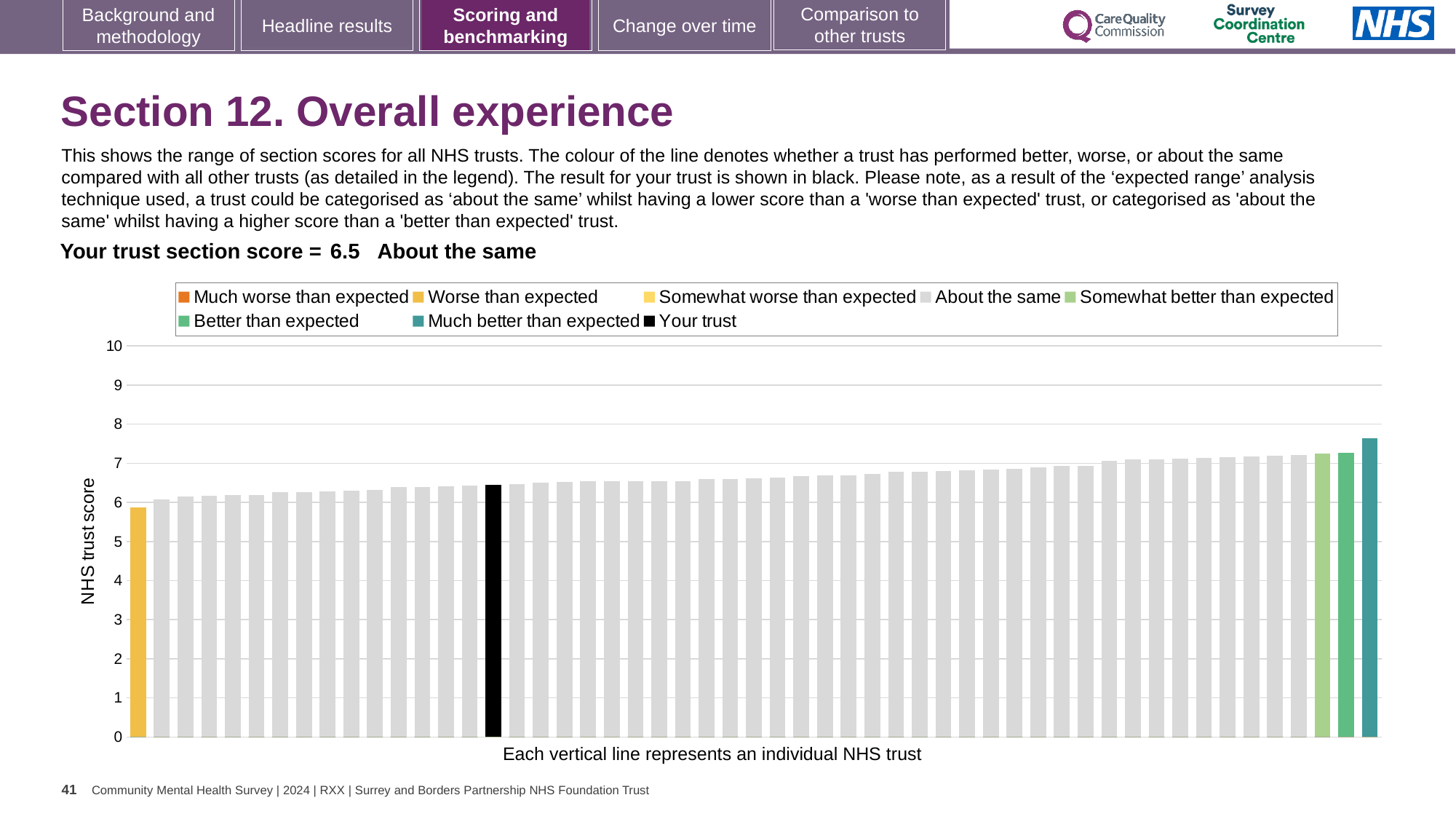
How many entries does the chart legend list? 8 Is the value of the leftmost yellow bar (Worse than expected) greater or less than 5? greater How many trusts are shown in the 'Much better than expected' colour? 1 Do the bar values rise or fall from left to right along the x axis? rise What kind of chart is shown on the slide? bar chart What is the section score for your trust shown on the slide? 6.5 Is the value of the black 'Your trust' bar greater or less than 7? less Is the 'Your trust' bar higher or lower than the 'Much better than expected' bar? lower How is your trust's section score categorised compared with other trusts? About the same Which legend category does the tallest bar belong to? Much better than expected Is the value of the tallest bar (Much better than expected) greater or less than 7? greater What is the label on the y axis of the chart? NHS trust score